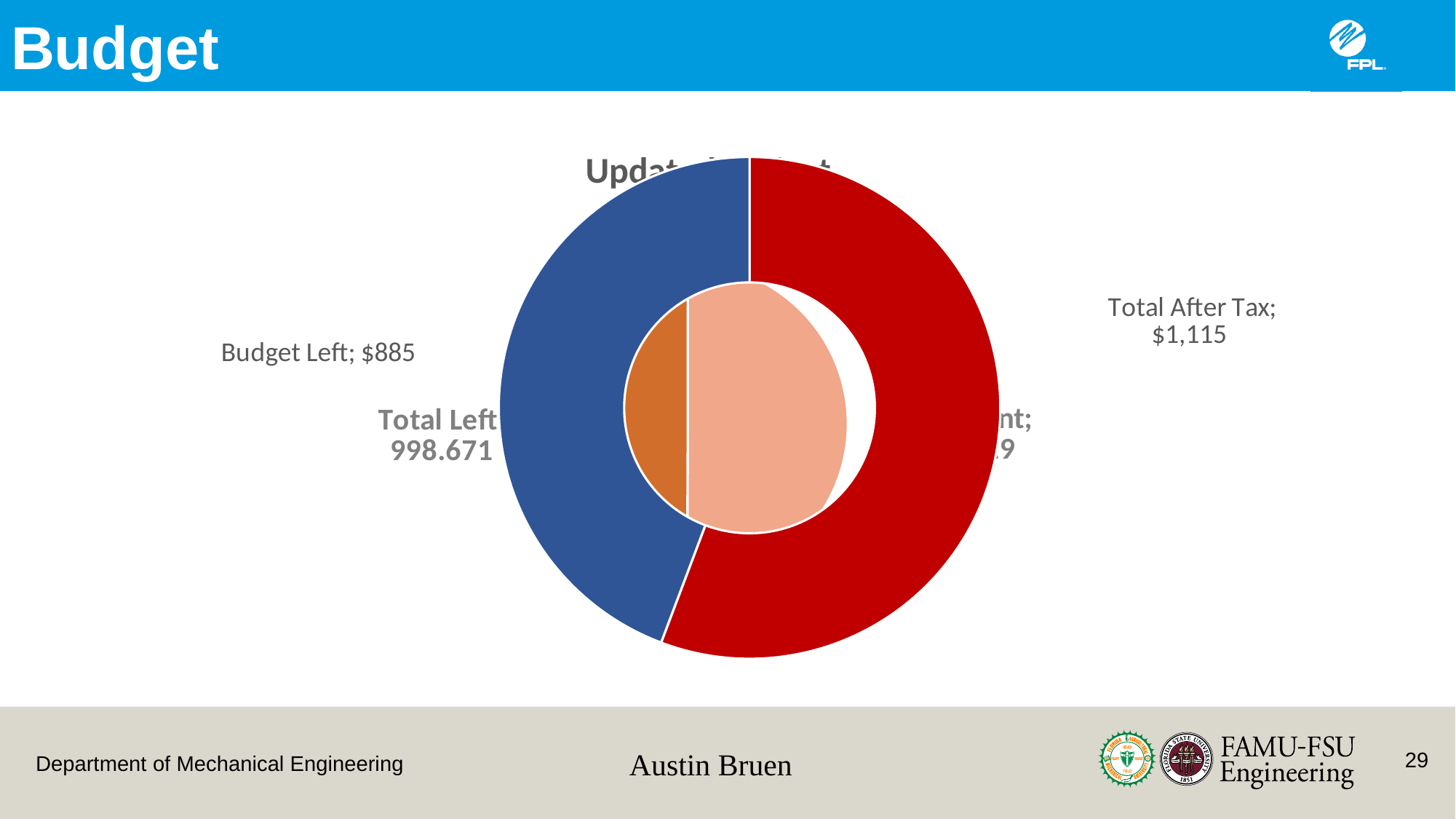
What is the value shown for Total After Tax in the outer ring? $1,115 What is the value shown for Budget Left in the outer ring? $885 What is the value shown for Total Left in the inner ring? 998.671 Which segment of the outer ring has the lowest value? Budget Left How many segments does the outer ring of the chart have? 2 Which is larger in the outer ring, Budget Left or Total After Tax? Total After Tax How many rings does the doughnut chart have? 1 What share of the outer ring does Budget Left represent? 44.25% What kind of chart is shown on the slide? a doughnut chart with a pie chart inside it What colour is the Budget Left segment in the outer ring? blue Which segment of the outer ring has the highest value? Total After Tax What is the difference between Total After Tax and Budget Left in the outer ring? $230